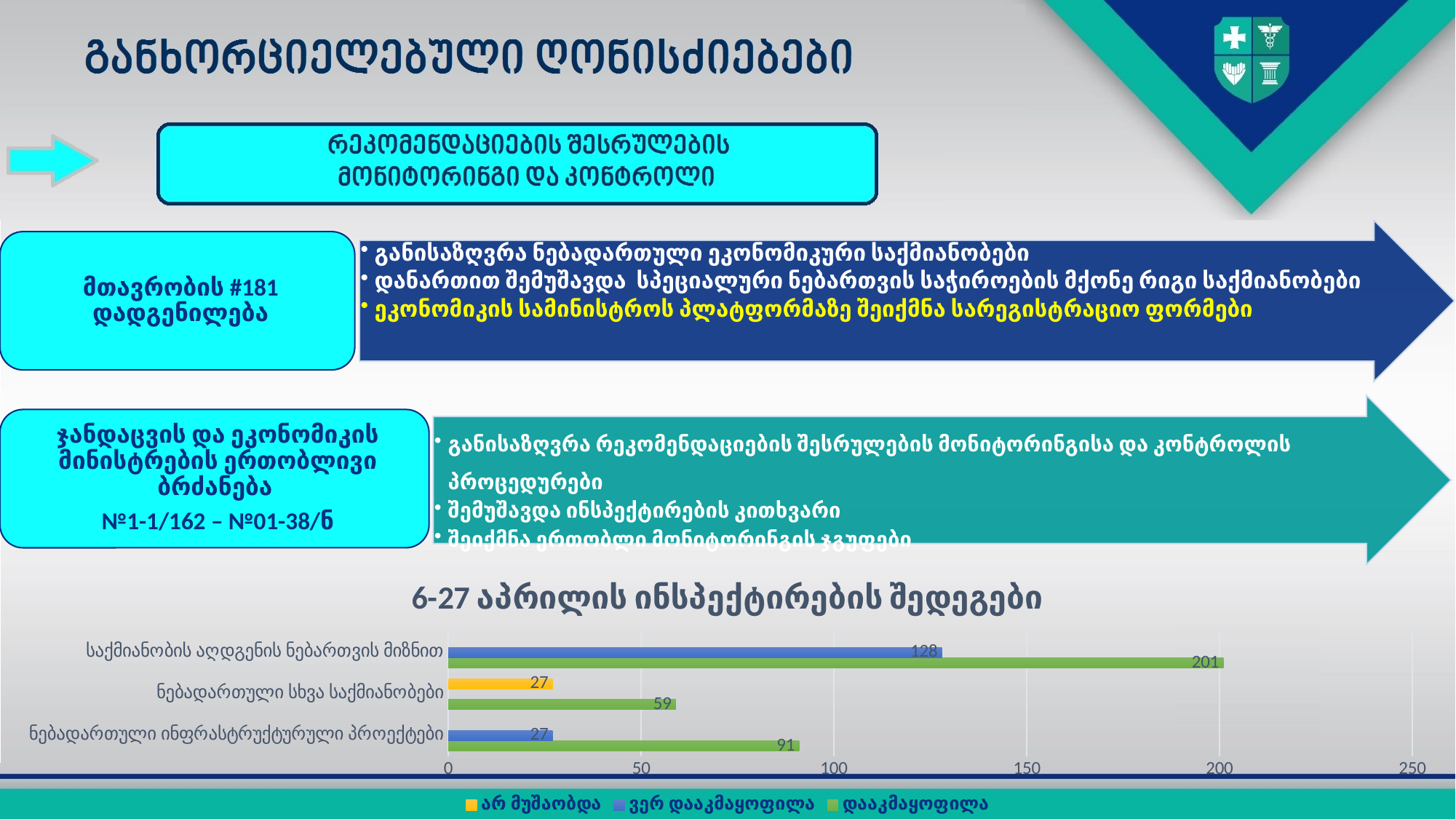
What is the difference between the დააკმაყოფილა and ვერ დააკმაყოფილა values for საქმიანობის აღდგენის ნებართვის მიზნით? 73 Which category has the highest დააკმაყოფილა value? საქმიანობის აღდგენის ნებართვის მიზნით What is the value of ვერ დააკმაყოფილა for საქმიანობის აღდგენის ნებართვის მიზნით? 128 What is the value of დააკმაყოფილა for ნებადართული ინფრასტრუქტურული პროექტები? 91 How many categories are shown on the chart's vertical axis? 3 What is the title of the chart? 6-27 აპრილის ინსპექტირების შედეგები Which is larger: the დააკმაყოფილა value for ნებადართული ინფრასტრუქტურული პროექტები or for ნებადართული სხვა საქმიანობები? ნებადართული ინფრასტრუქტურული პროექტები How many series does the chart legend list? 3 Which category has the lowest დააკმაყოფილა value? ნებადართული სხვა საქმიანობები What type of chart is shown on the slide? bar chart What is the value of დააკმაყოფილა for საქმიანობის აღდგენის ნებართვის მიზნით? 201 What is the value of არ მუშაობდა for ნებადართული სხვა საქმიანობები? 27